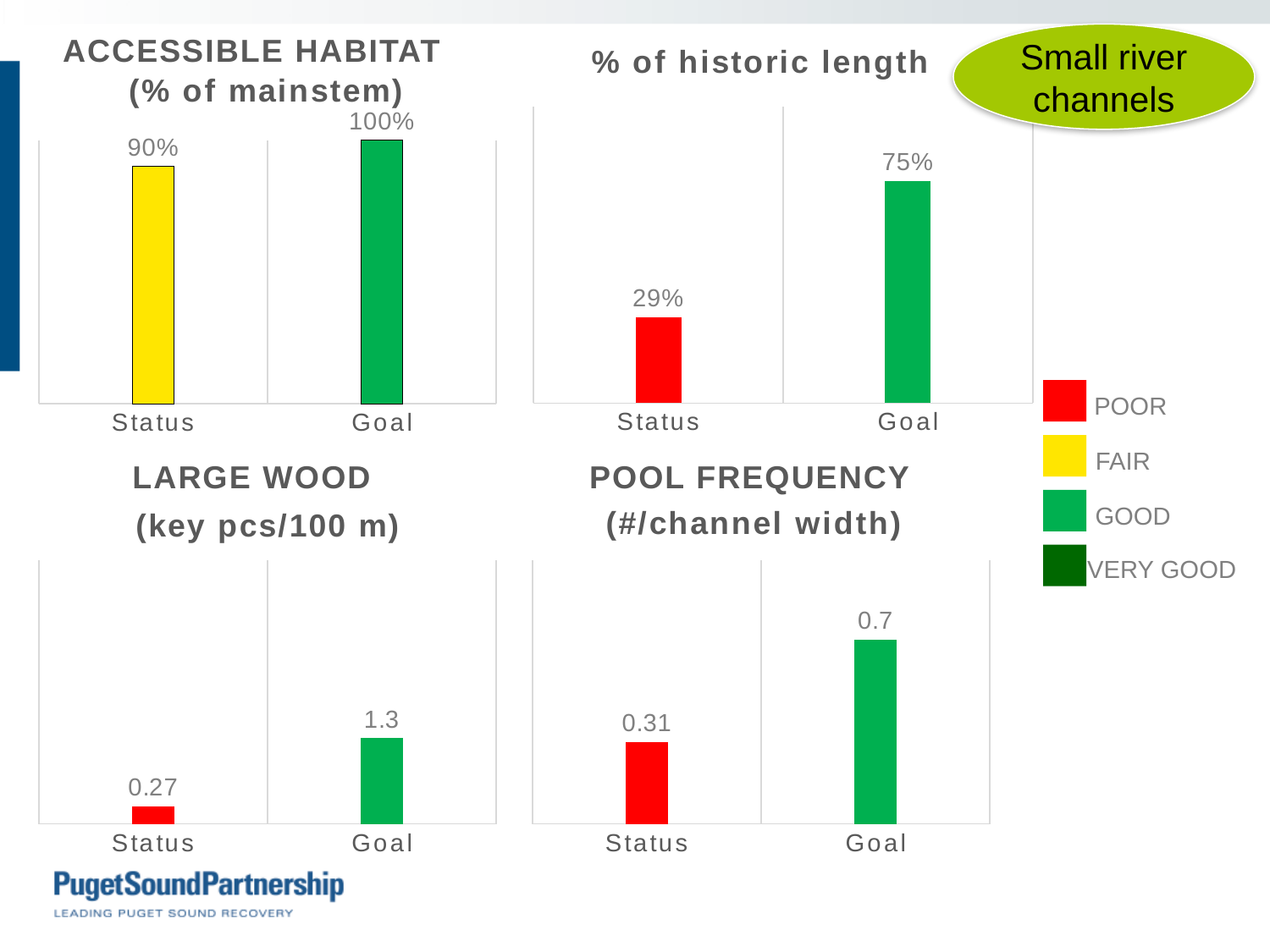
What kind of chart is the LARGE WOOD chart? Bar chart In the % of historic length chart, what is the difference between the Goal and Status values? 46% How many categories does the ACCESSIBLE HABITAT chart show? 2 In the LARGE WOOD chart, what is the value for Goal? 1.3 In the POOL FREQUENCY chart, which is larger, Status or Goal? Goal In the ACCESSIBLE HABITAT chart, what is the value for Goal? 100% In the LARGE WOOD chart, which category has the lowest value? Status In the ACCESSIBLE HABITAT chart, what is the value for Status? 90% In the POOL FREQUENCY chart, what is the difference between Goal and Status? 0.39 In the % of historic length chart, what is the value for Status? 29% According to the legend on the slide, what rating does the yellow colour represent? FAIR In the POOL FREQUENCY chart, what is the value for Status? 0.31